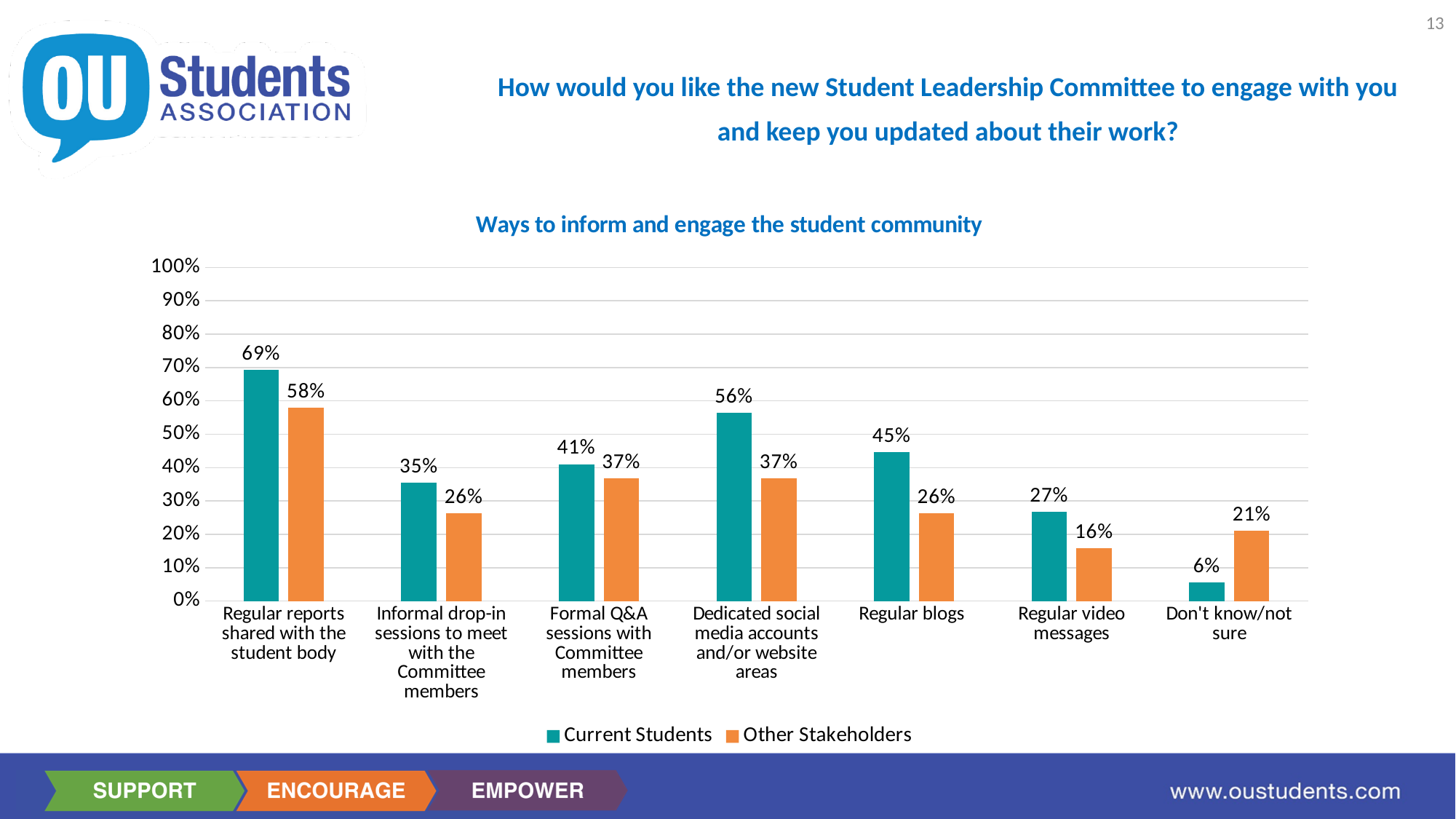
Which category has the lowest value for Current Students? Don't know/not sure What is the title of the chart? Ways to inform and engage the student community What type of chart is shown on the slide? Bar chart What is the difference between the Current Students and Other Stakeholders values for Regular blogs? 19% Which category has the lowest value for Other Stakeholders? Regular video messages What is the Current Students value for Dedicated social media accounts and/or website areas? 56% What is the Other Stakeholders value for Regular video messages? 16% What percentage of Current Students chose Regular reports shared with the student body? 69% How many categories are shown on the x axis? 7 For Don't know/not sure, which series has the larger value: Current Students or Other Stakeholders? Other Stakeholders How many series does the legend list? 2 Which category has the highest value for Current Students? Regular reports shared with the student body